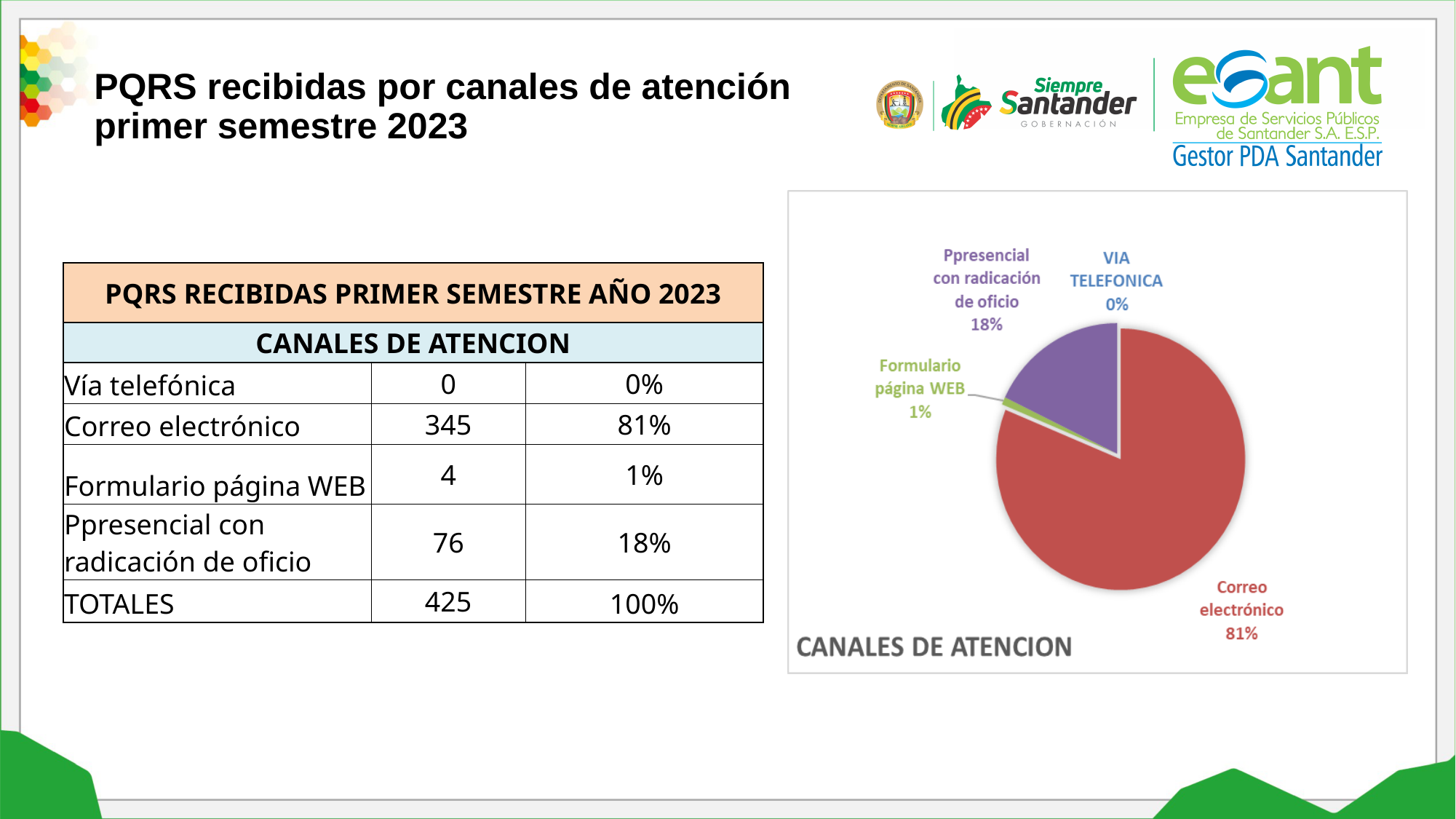
What share of the pie does Correo electrónico have? 81% What colour is the Correo electrónico slice? red What share of the pie does Formulario página WEB have? 1% What share of the pie does VIA TELEFONICA have? 0% What kind of chart is shown on the slide? pie chart Which is larger, the share for Ppresencial con radicación de oficio or the share for Formulario página WEB? Ppresencial con radicación de oficio Which category has the largest slice of the pie? Correo electrónico Which category has the smallest slice of the pie? VIA TELEFONICA What is the title of the chart? CANALES DE ATENCION What is the difference in percentage points between the Correo electrónico share and the Ppresencial con radicación de oficio share? 63% How many categories are labelled on the pie chart? 4